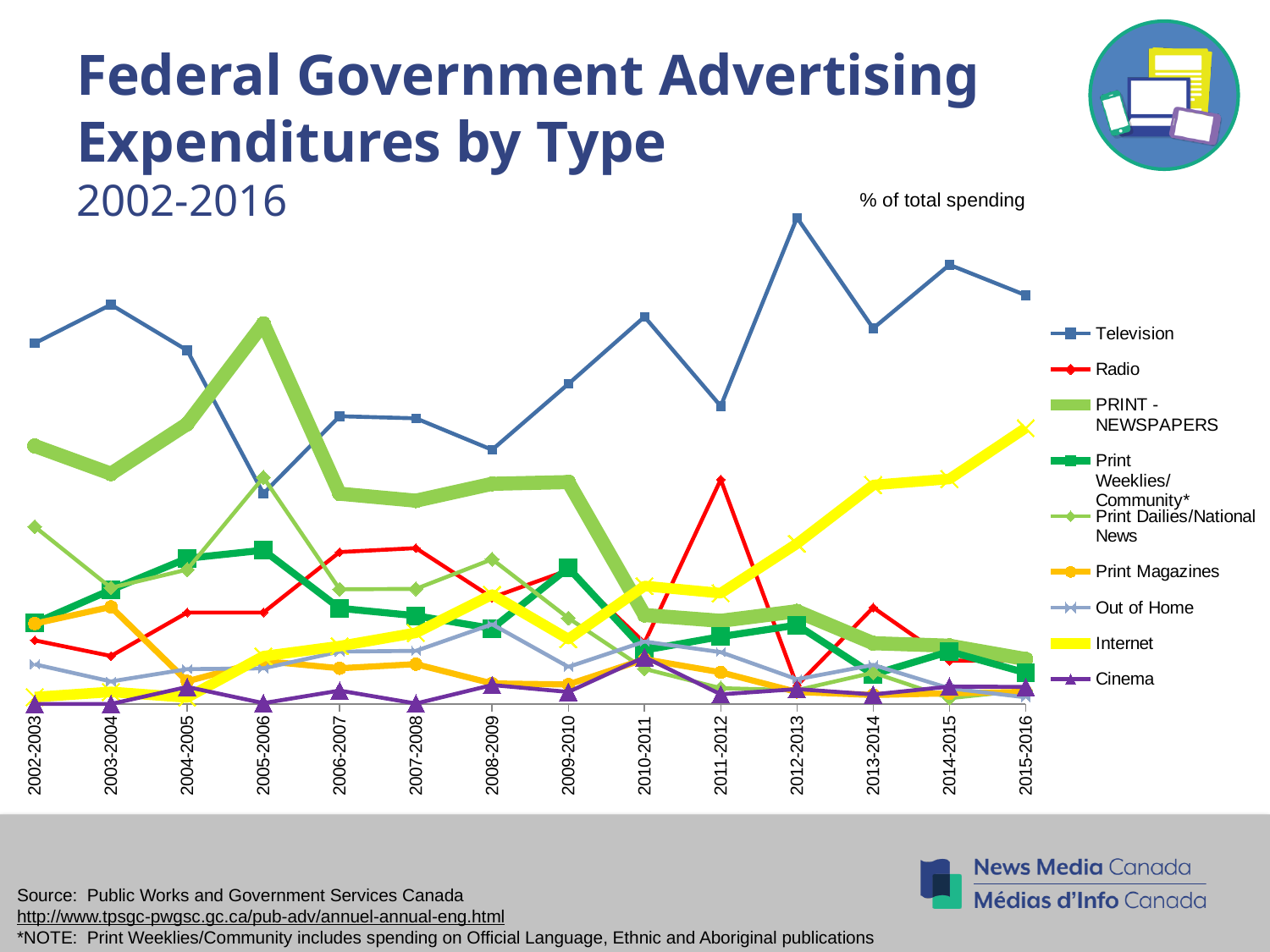
How many series does the legend list? 9 What unit does the chart say the values are measured in? % of total spending What kind of chart is shown on the slide? line chart In 2015-2016, which is larger: Internet or Radio? Internet Which series has the lowest share of spending in 2005-2006? Cinema Which series has the highest share of spending in 2005-2006? PRINT - NEWSPAPERS Which series has the highest share of spending in 2012-2013? Television Does the Internet series rise or fall overall from 2002-2003 to 2015-2016? rise In 2011-2012, which is larger: Radio or Internet? Radio Does the PRINT - NEWSPAPERS series rise or fall from 2009-2010 to 2015-2016? fall How many fiscal years are plotted along the x axis? 14 Which series has the highest share of spending in 2002-2003? Television